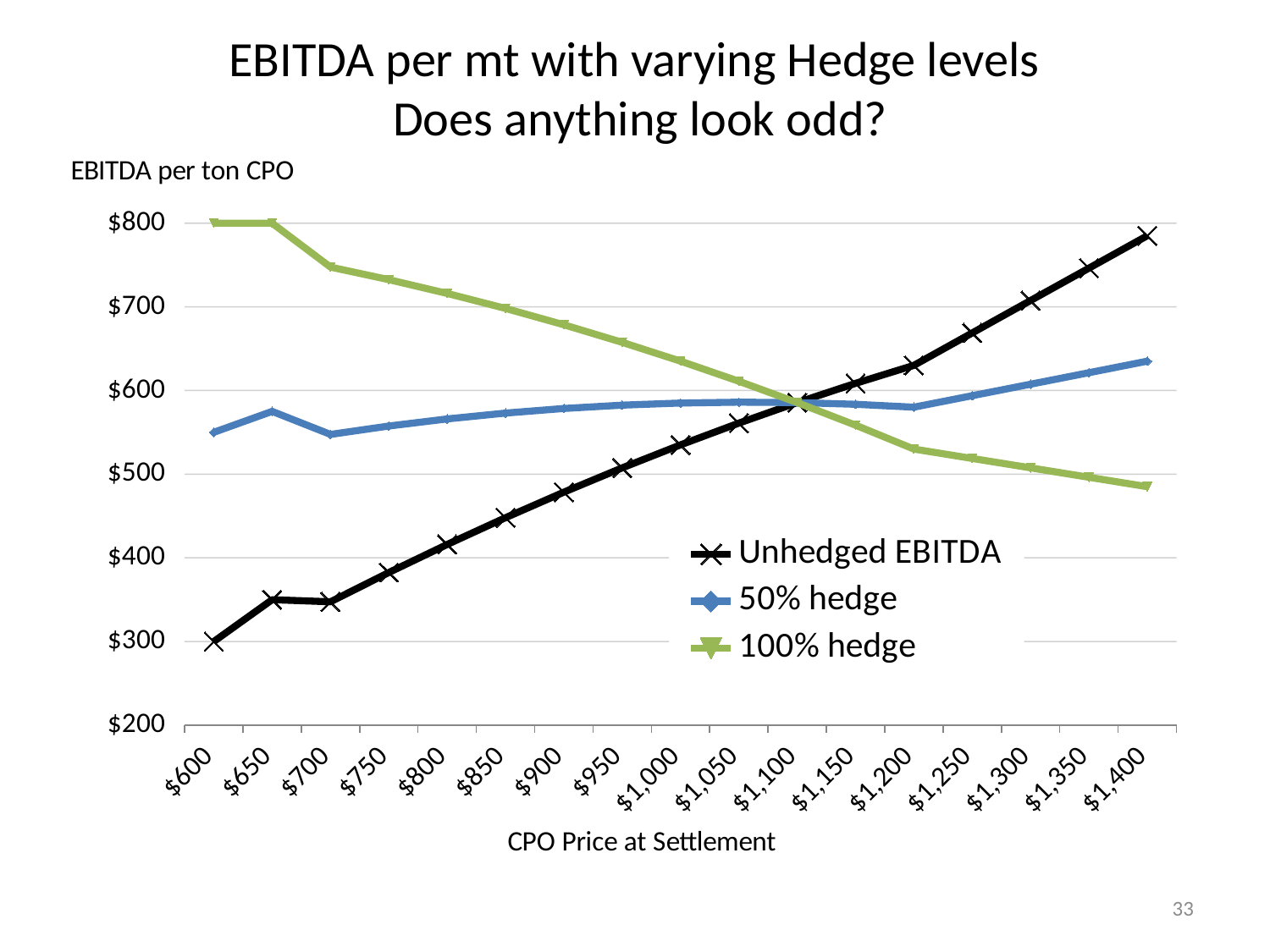
How many series does the legend list? 3 Which series is plotted with the green line with triangle markers? 100% hedge How many CPO price points are shown along the x axis? 17 Is the Unhedged EBITDA value at a CPO price of $1,400 greater or less than $700? greater Which series has the highest EBITDA per ton at a CPO price of $1,400? Unhedged EBITDA Is the 100% hedge value at a CPO price of $1,400 greater or less than $500? less Which series has the lowest EBITDA per ton at a CPO price of $600? Unhedged EBITDA What is the x-axis label of the chart? CPO Price at Settlement Does the Unhedged EBITDA line rise or fall as the CPO price increases from $600 to $1,400? Rises Does the 100% hedge line rise or fall as the CPO price increases from $600 to $1,400? Falls What kind of chart is shown on the slide? Line chart At a CPO price of $600, which is larger: the 100% hedge value or the Unhedged EBITDA value? 100% hedge